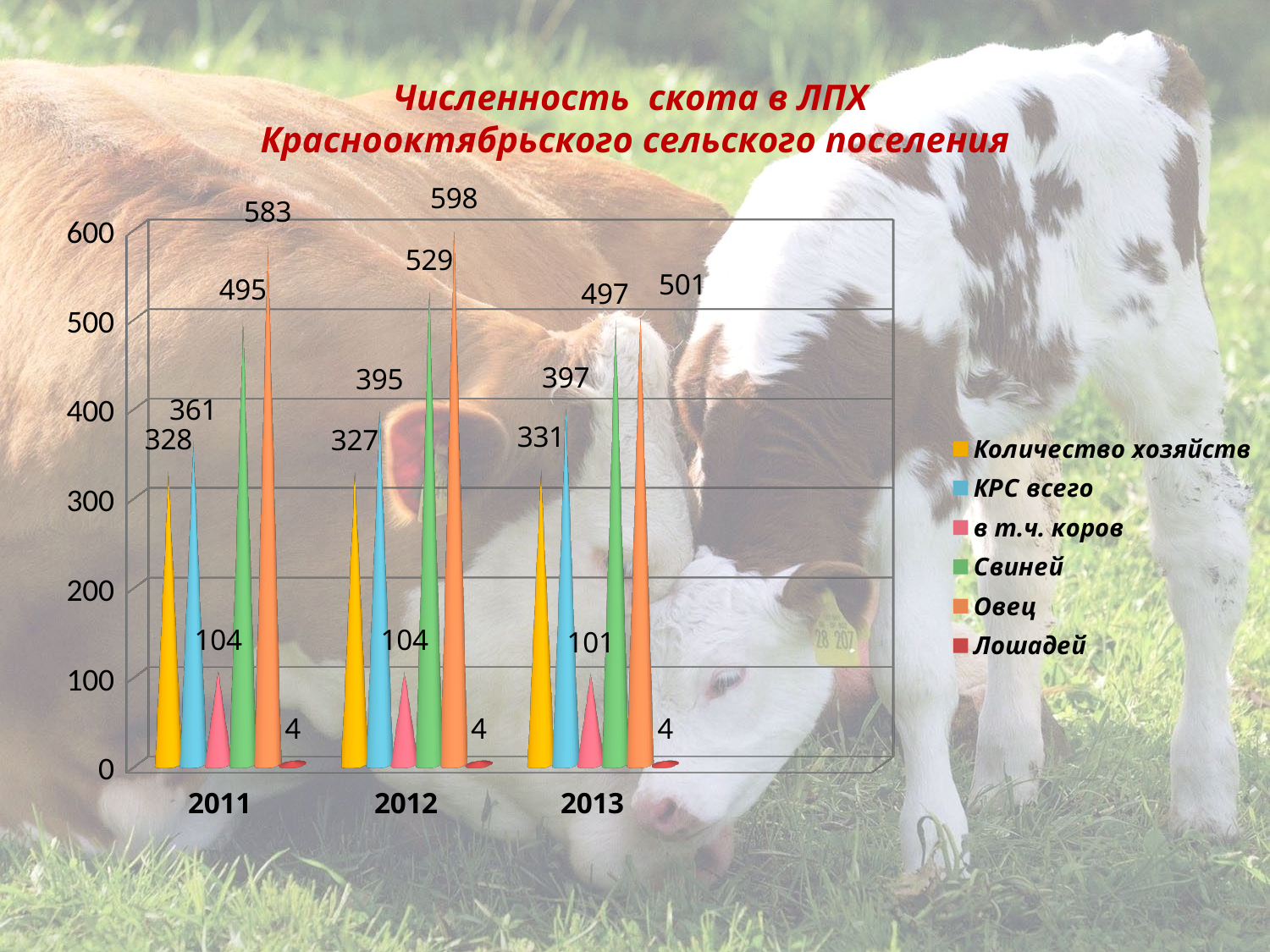
What is the value for в т.ч. коров in 2013? 101 How many years are shown on the x axis? 3 How many series does the legend list? 6 Which is larger in 2013: the value for Свиней or the value for Овец? Овец What is the value for Овец in 2012? 598 What is the difference between the КРС всего values for 2013 and 2011? 36 Does the value for КРС всего rise or fall from 2011 to 2013? rise In which year is the value for Свиней highest? 2012 What is the value for Количество хозяйств in 2012? 327 What is the difference between the Овец values for 2012 and 2011? 15 Which series has the lowest value in 2013? Лошадей What is the value for КРС всего in 2011? 361